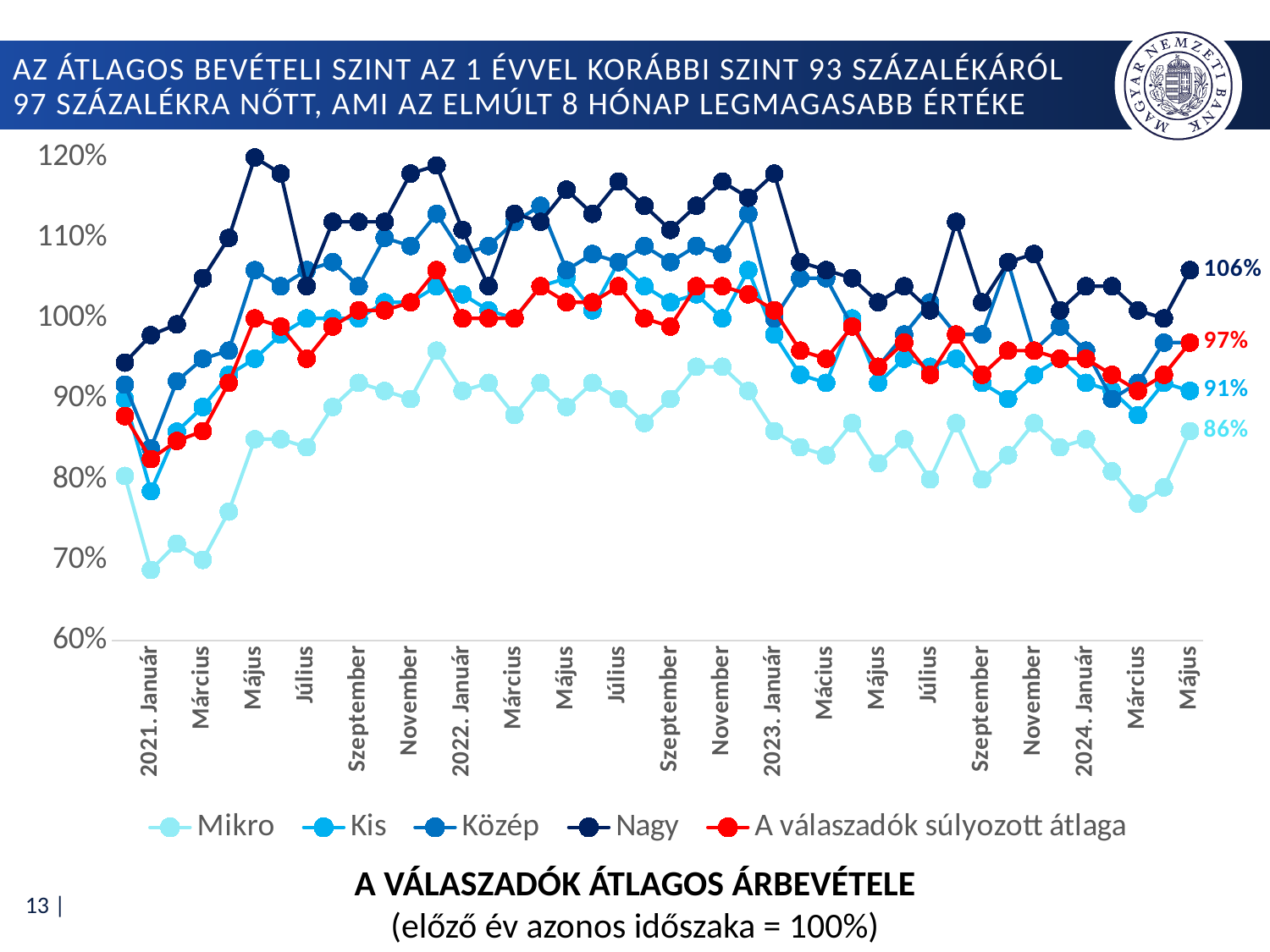
Which series has the lowest value at the last point (2024 Május)? Mikro What is the value for Kis at the last point (2024 Május)? 91% What is the value for Mikro at the last point (2024 Május)? 86% Is the value for Nagy in 2021 Május greater or less than 110%? greater What is the value for A válaszadók súlyozott átlaga at the last point (2024 Május)? 97% At the last point (2024 Május), is the value for Nagy or for Mikro larger? Nagy What is the value for Nagy at the last point (2024 Május)? 106% Which series has the highest value at the last point (2024 Május)? Nagy What is the title of the chart? A VÁLASZADÓK ÁTLAGOS ÁRBEVÉTELE (előző év azonos időszaka = 100%) What kind of chart is shown on the slide? Line chart How many series does the legend list? 5 What is the difference between the Nagy and Mikro values at the last point (2024 Május)? 20 percentage points